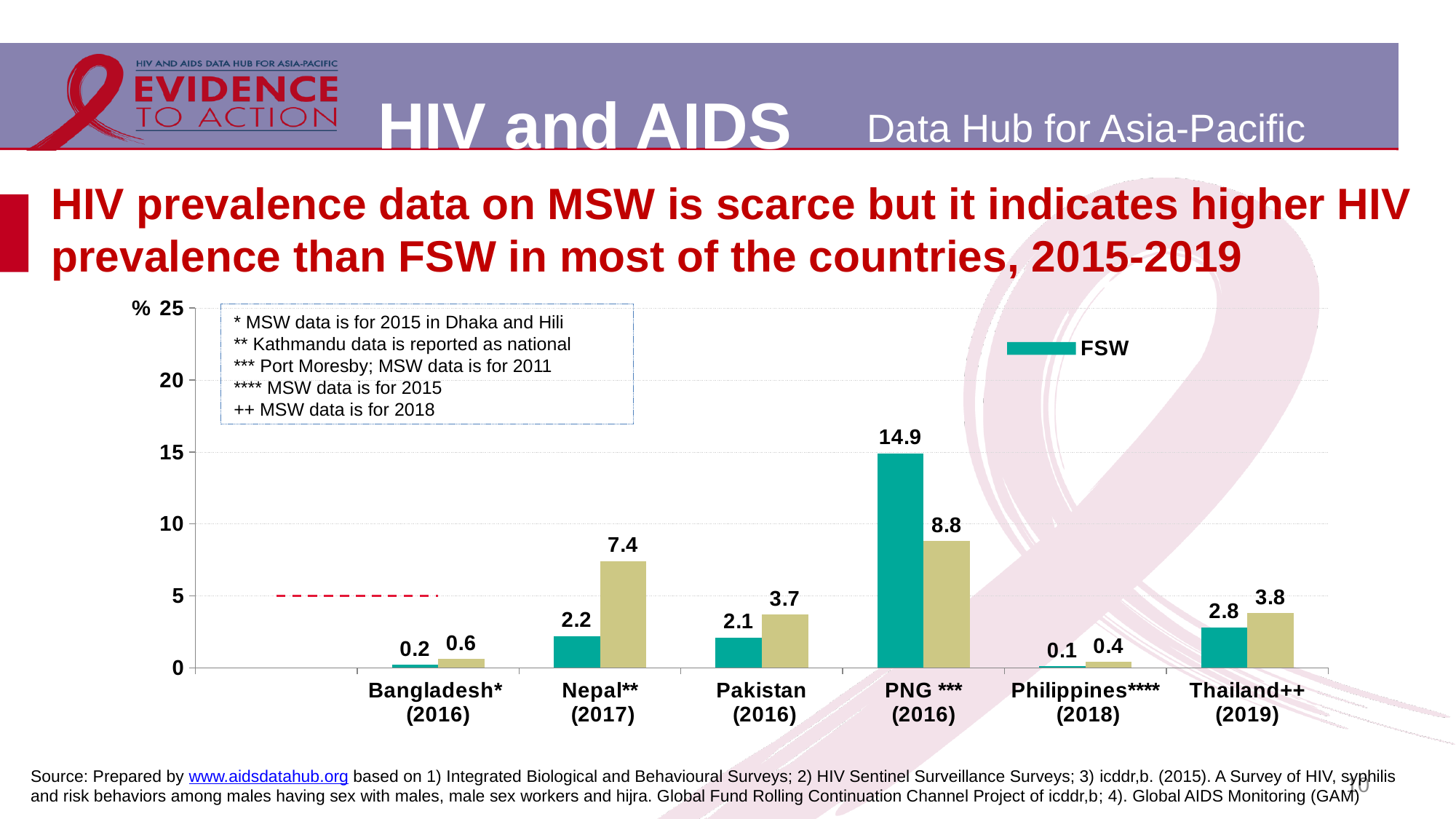
Which country has the highest FSW value? PNG *** (2016) What kind of chart is shown on the slide? bar chart Which series name is shown in the chart legend? FSW What is the FSW value for Nepal** (2017)? 2.2 What is the value of the tan bar for Nepal** (2017)? 7.4 What is the value of the tan bar for Thailand++ (2019)? 3.8 How many countries are shown on the x axis? 6 What is the difference between the FSW bar and the tan bar for PNG *** (2016)? 6.1 What is the FSW value for PNG *** (2016)? 14.9 For Pakistan (2016), which is larger: the FSW bar or the tan bar? the tan bar Which country has the lowest FSW value? Philippines**** (2018) What is the difference between the tan bar and the FSW bar for Nepal** (2017)? 5.2